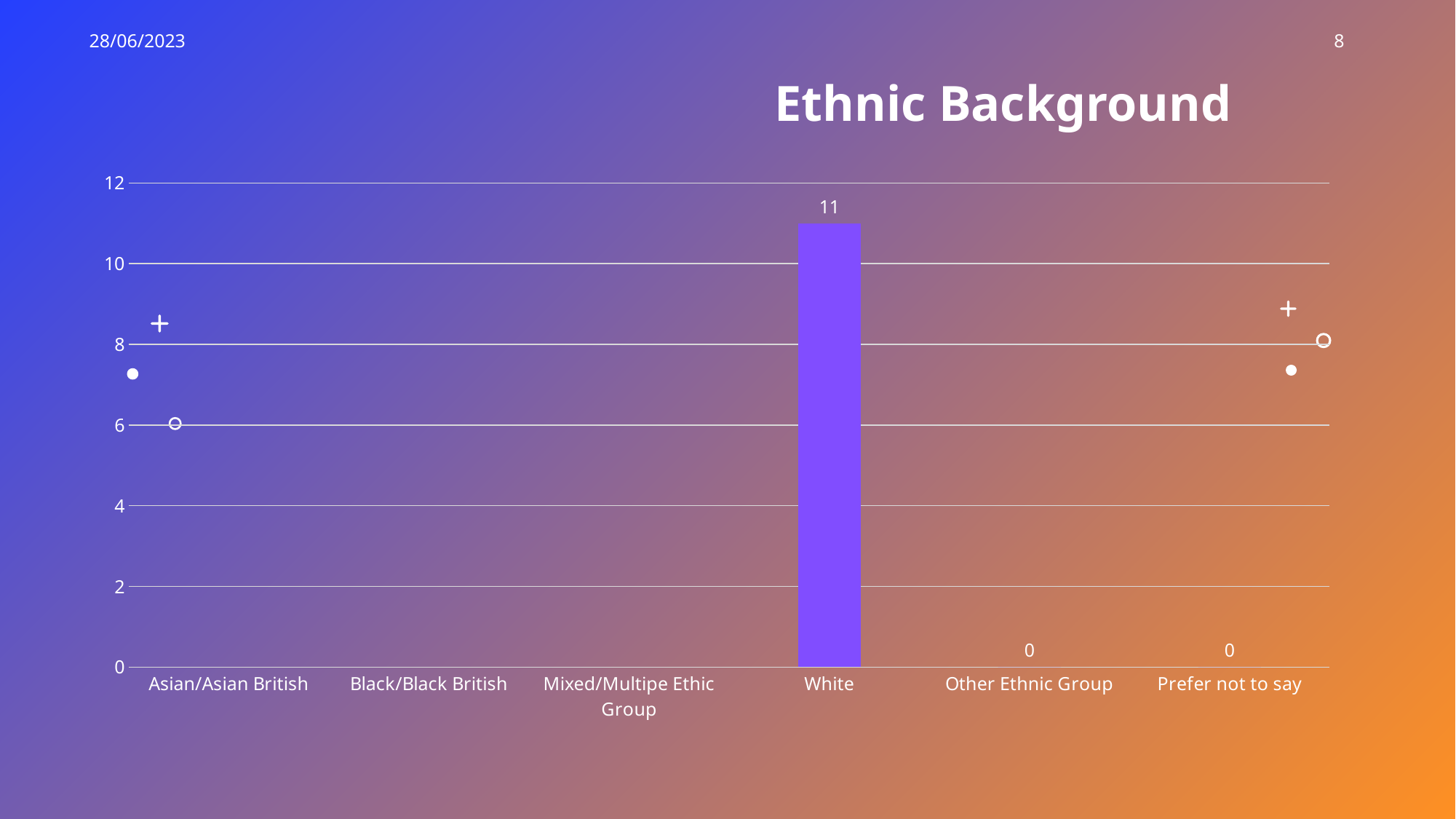
Is the value for White greater or less than 10? greater What is the highest value shown on the y axis? 12 Which is larger, the value for White or the value for Prefer not to say? White Which category has the highest value? White What is the value for Prefer not to say? 0 What is the difference between the values for White and Other Ethnic Group? 11 What kind of chart is shown on the slide? bar chart What is the title of the chart? Ethnic Background How many categories are shown on the x axis? 6 What is the value for Other Ethnic Group? 0 What is the value for White? 11